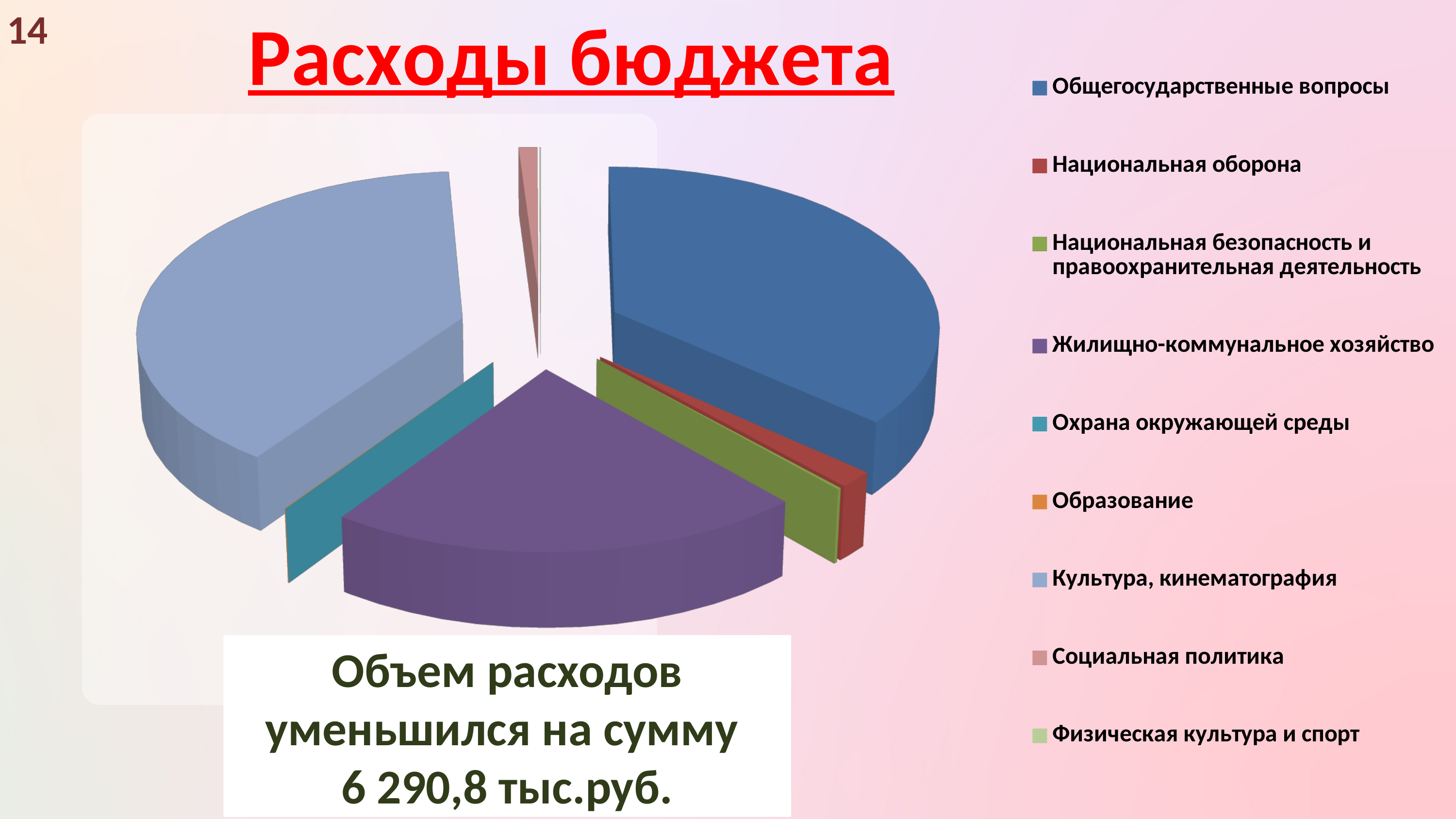
What kind of chart is shown on the slide? pie chart What colour is the slice for Жилищно-коммунальное хозяйство in the pie chart? purple Which slice is larger: Общегосударственные вопросы or Национальная безопасность и правоохранительная деятельность? Общегосударственные вопросы What is the title of the slide containing the pie chart? Расходы бюджета Which slice is larger: Культура, кинематография or Охрана окружающей среды? Культура, кинематография Which slice is larger: Жилищно-коммунальное хозяйство or Национальная оборона? Жилищно-коммунальное хозяйство How many categories does the legend of the pie chart list? 9